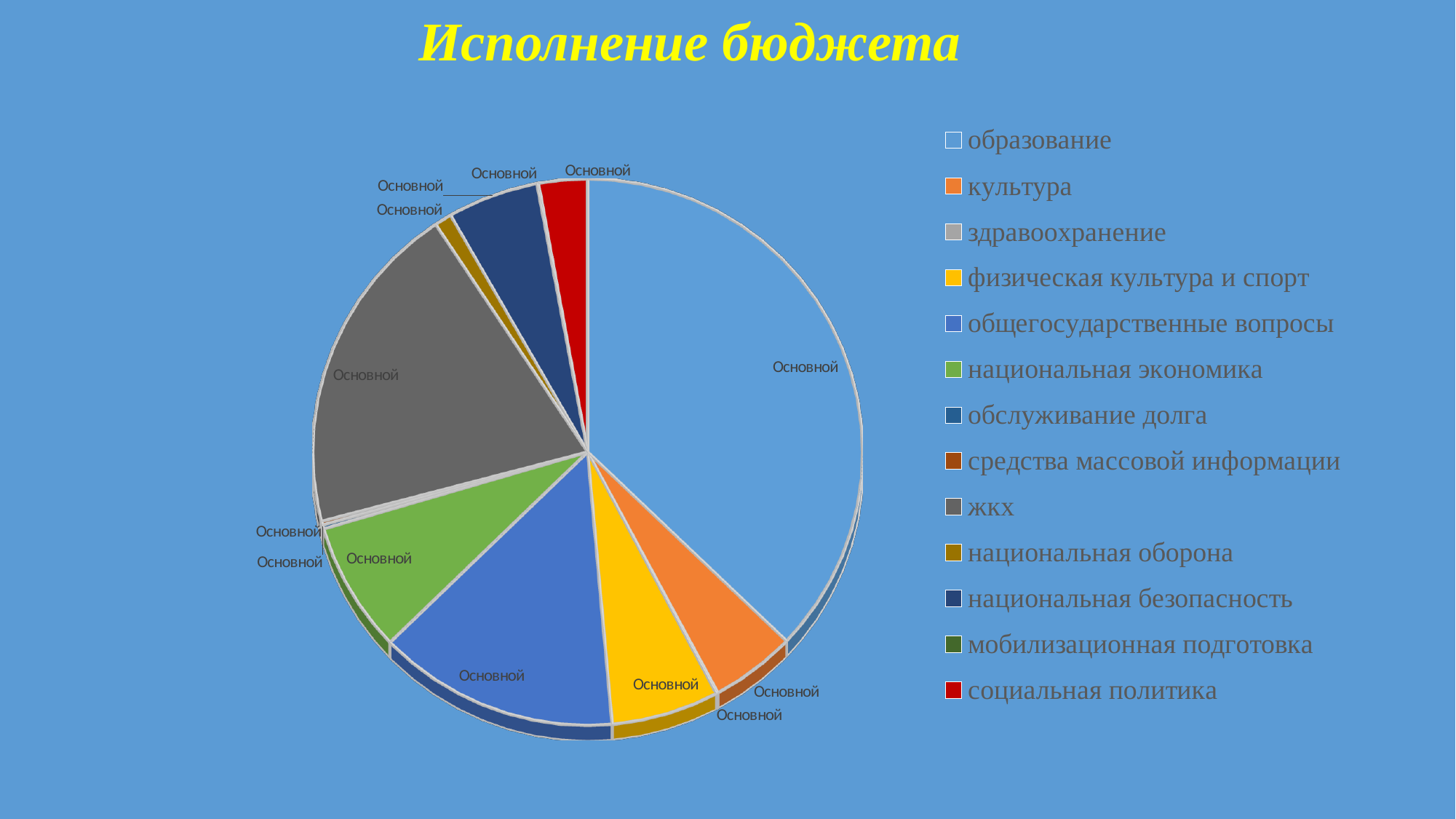
Which slice is larger, национальная безопасность or социальная политика? национальная безопасность Which slice is larger, общегосударственные вопросы or физическая культура и спорт? общегосударственные вопросы Which slice is larger, образование or жкх? образование Which category has the largest slice of the pie? образование What is the title of the chart? Исполнение бюджета How many categories does the legend of the pie chart list? 13 What kind of chart is shown on the slide? pie chart Which category is shown in red in the legend? социальная политика